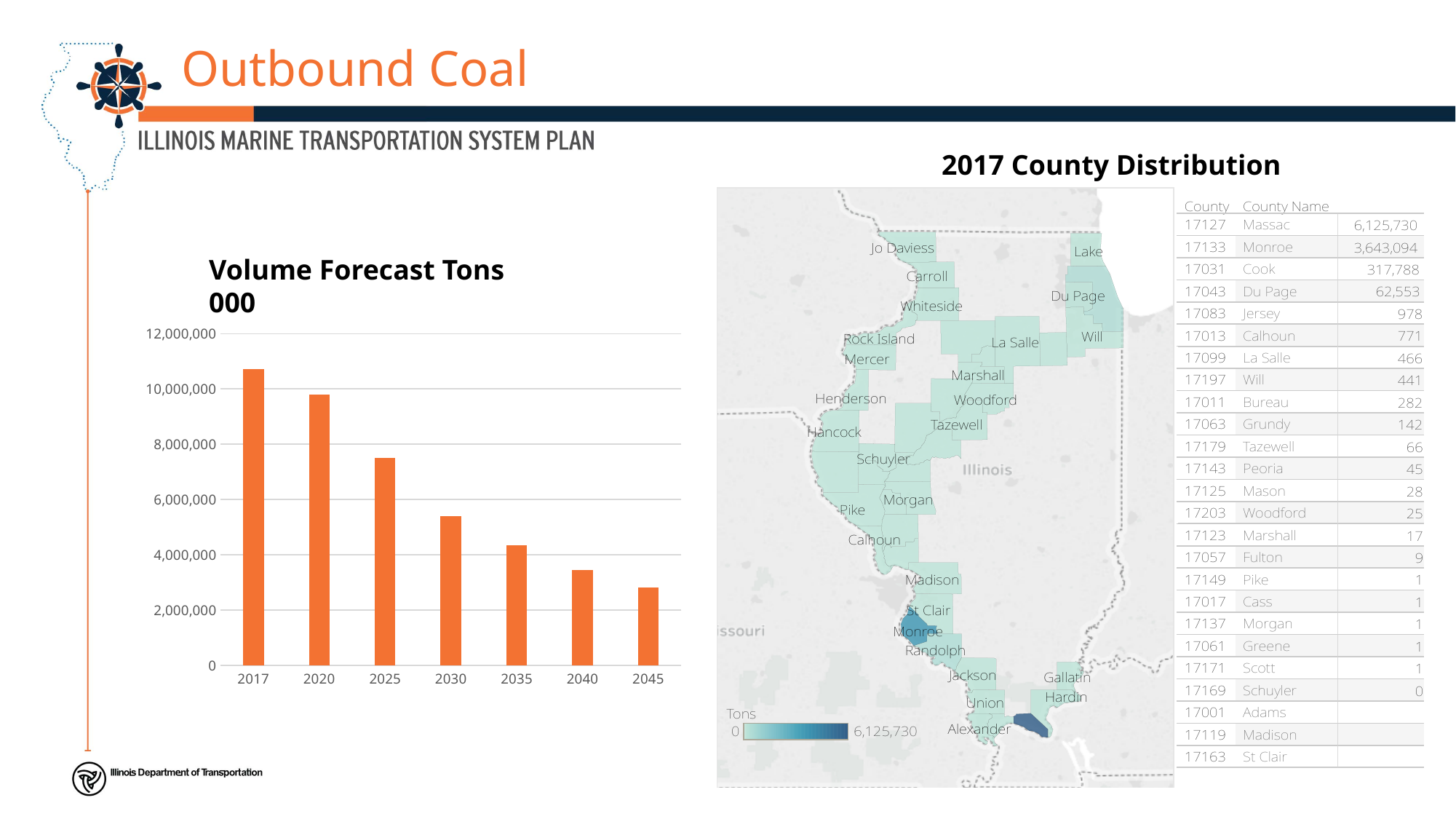
In the Volume Forecast Tons 000 chart, is the value for 2040 greater or less than 4,000,000? less What is the title of the map chart on the right side of the slide? 2017 County Distribution What kind of chart is the Volume Forecast Tons 000 chart? bar chart In the Volume Forecast Tons 000 chart, do the values rise or fall from 2017 to 2045? fall In the Volume Forecast Tons 000 chart, is the value for 2017 greater or less than 10,000,000? greater In the Volume Forecast Tons 000 chart, which year has the highest value? 2017 In the Volume Forecast Tons 000 chart, which year has the larger value, 2025 or 2030? 2025 In the Volume Forecast Tons 000 chart, is the value for 2020 greater or less than 10,000,000? less In the Volume Forecast Tons 000 chart, which year has the lowest value? 2045 In the Volume Forecast Tons 000 chart, how many years are shown on the x axis? 7